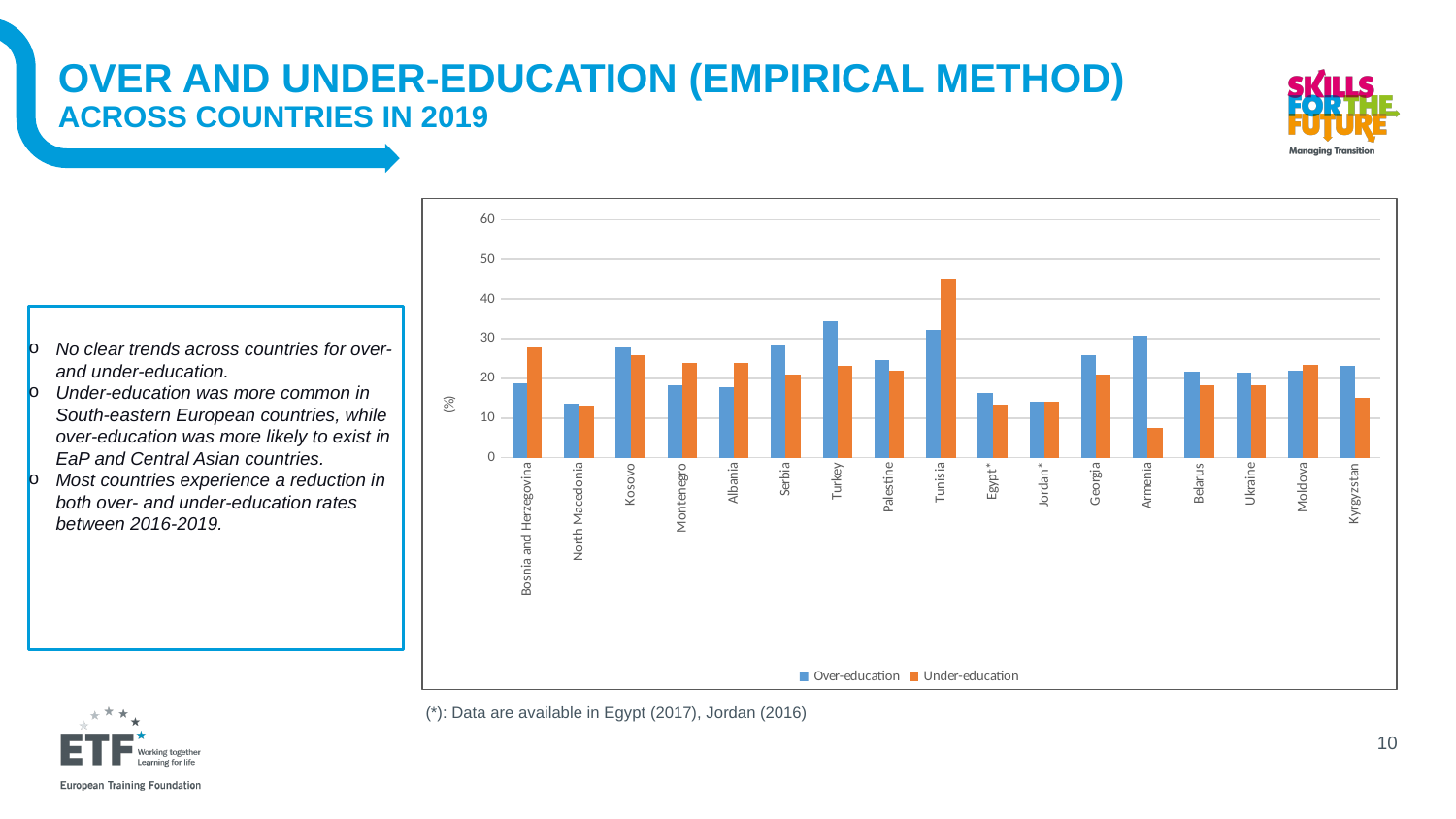
What kind of chart is shown on the slide? bar chart How many countries are shown on the x axis of the chart? 17 Is the under-education value for Armenia greater or less than 10? less For Bosnia and Herzegovina, which is larger: over-education or under-education? Under-education Which country has the highest under-education value? Tunisia Is the over-education value for Turkey greater or less than 30? greater What is the label on the vertical axis of the chart? (%) Is the over-education value for North Macedonia greater or less than 20? less For Armenia, which is larger: over-education or under-education? Over-education How many series does the chart legend list? 2 Which country has the lowest under-education value? Armenia